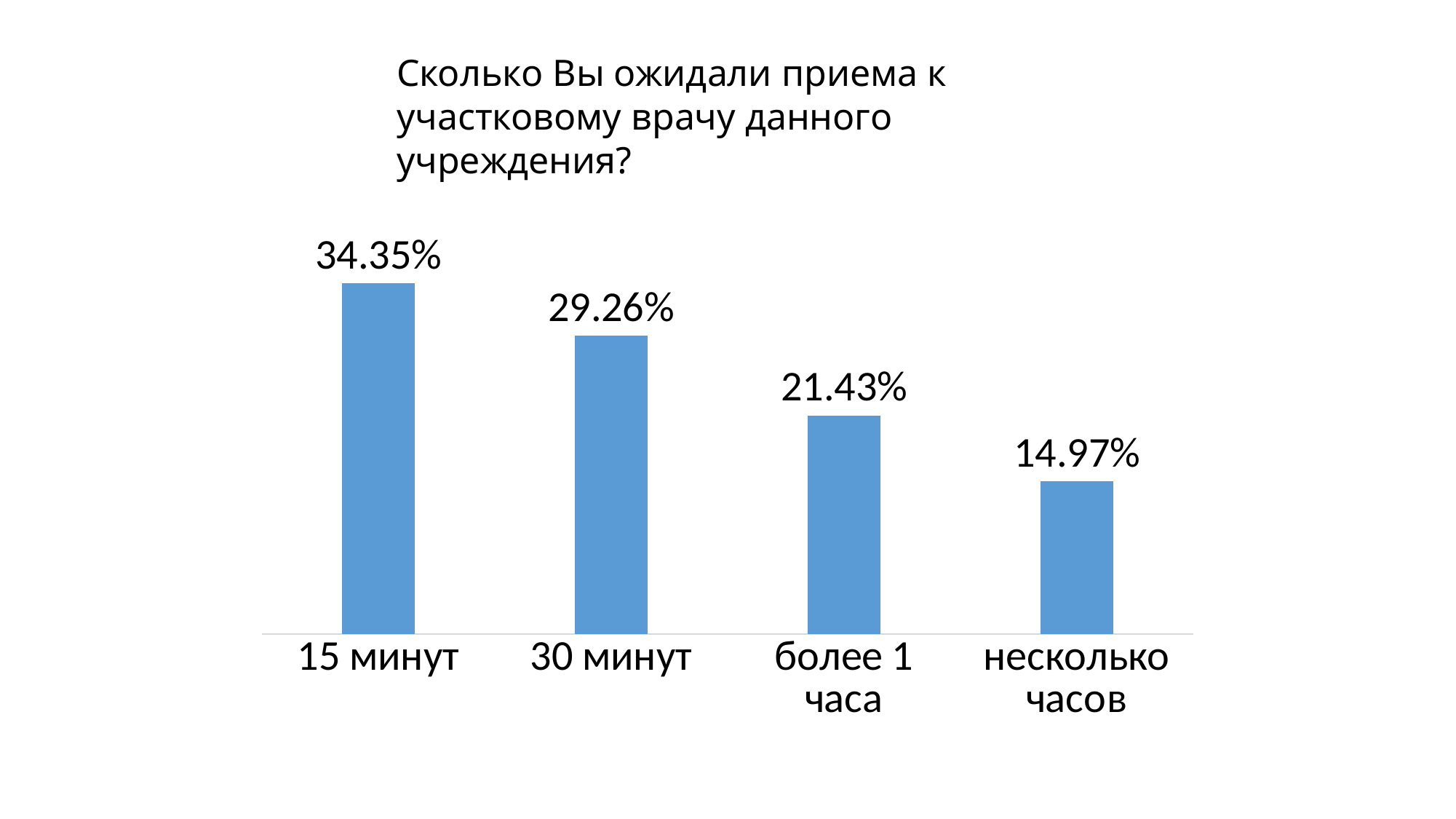
How many categories are shown in the chart? 4 What is the value for "15 минут"? 34.35% What is the value for "30 минут"? 29.26% What is the value for "более 1 часа"? 21.43% Which category has the lowest value? несколько часов What is the difference between the values for "более 1 часа" and "несколько часов"? 6.46% Do the values rise or fall from left to right along the x axis? fall Which is larger, the value for "30 минут" or the value for "более 1 часа"? 30 минут Which category has the highest value? 15 минут What kind of chart is shown on the slide? bar chart What is the difference between the values for "15 минут" and "30 минут"? 5.09% What is the value for "несколько часов"? 14.97%